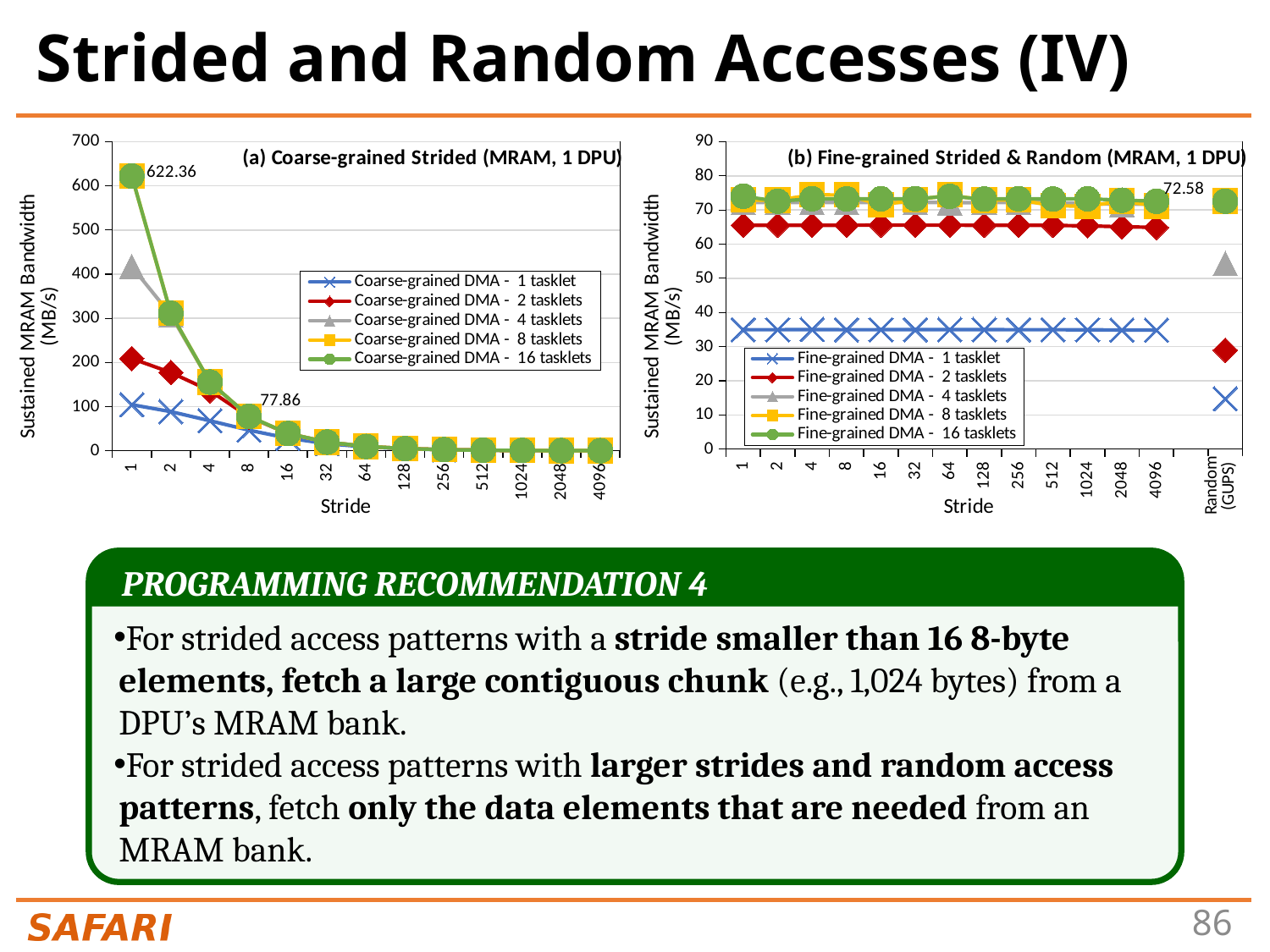
In chart (a) Coarse-grained Strided (MRAM, 1 DPU), what is the labeled bandwidth value at stride 1? 622.36 How many categories are on the x axis of chart (b) Fine-grained Strided & Random (MRAM, 1 DPU)? 14 In chart (b) Fine-grained Strided & Random (MRAM, 1 DPU), is the value for Fine-grained DMA - 2 tasklets at stride 1 greater or less than 60? greater How many stride values are on the x axis of chart (a) Coarse-grained Strided (MRAM, 1 DPU)? 13 In chart (b) Fine-grained Strided & Random (MRAM, 1 DPU), what is the labeled bandwidth value shown near stride 4096? 72.58 In chart (b) Fine-grained Strided & Random (MRAM, 1 DPU), is the value for Fine-grained DMA - 1 tasklet at Random (GUPS) greater or less than 20? less In chart (b) Fine-grained Strided & Random (MRAM, 1 DPU), is the value for Fine-grained DMA - 1 tasklet at stride 1 greater or less than 40? less What is the y-axis label of chart (b) Fine-grained Strided & Random (MRAM, 1 DPU)? Sustained MRAM Bandwidth (MB/s) What kind of chart is chart (a) Coarse-grained Strided (MRAM, 1 DPU)? Line chart In chart (a) Coarse-grained Strided (MRAM, 1 DPU), does the bandwidth for Coarse-grained DMA - 16 tasklets rise or fall as the stride increases? Fall How many series does the legend of chart (a) Coarse-grained Strided (MRAM, 1 DPU) list? 5